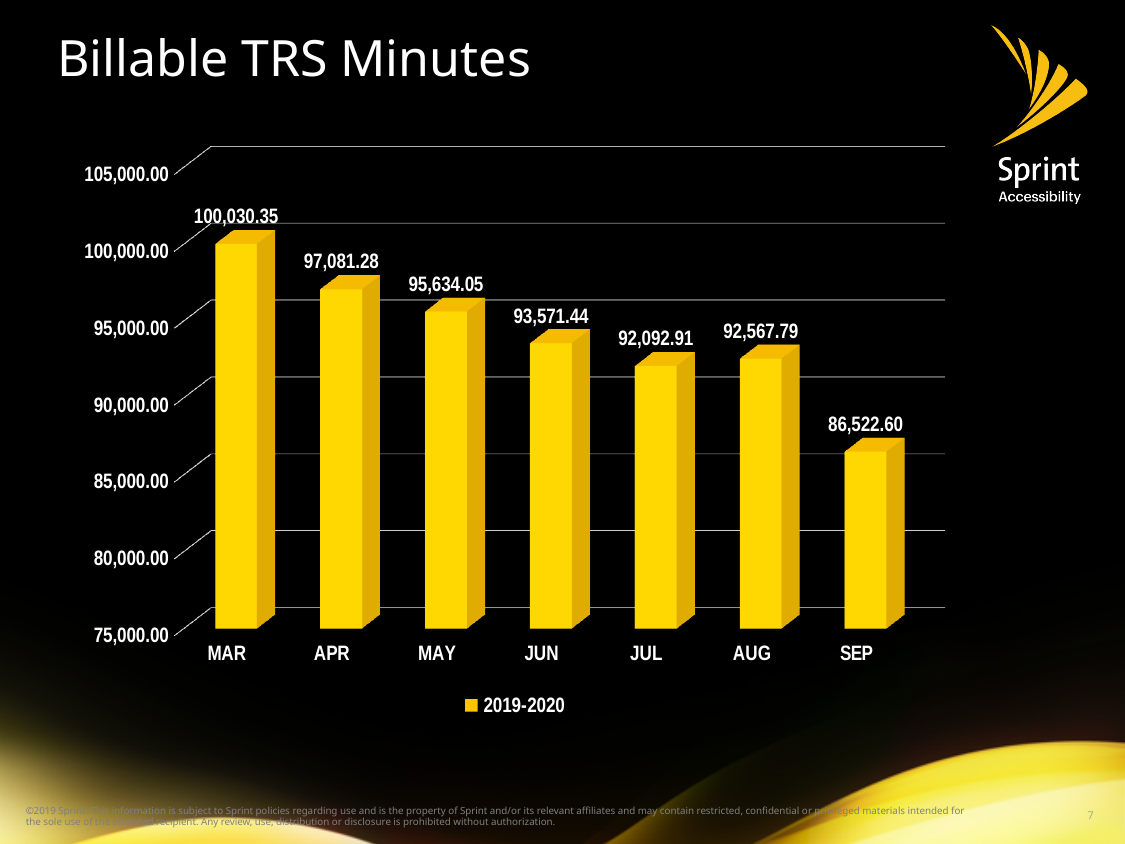
How many months are shown on the x axis? 7 What kind of chart is shown? Bar chart Which month has the lowest value? SEP What is the difference between the values for AUG and JUL? 474.88 Is the value for APR greater or less than 95,000.00? greater What is the difference between the values for MAR and SEP? 13,507.75 What is the value for MAR? 100,030.35 Which month has the highest value? MAR What series does the legend list? 2019-2020 Which is larger, the value for JUL or the value for AUG? AUG What is the value for SEP? 86,522.60 What is the value for JUN? 93,571.44